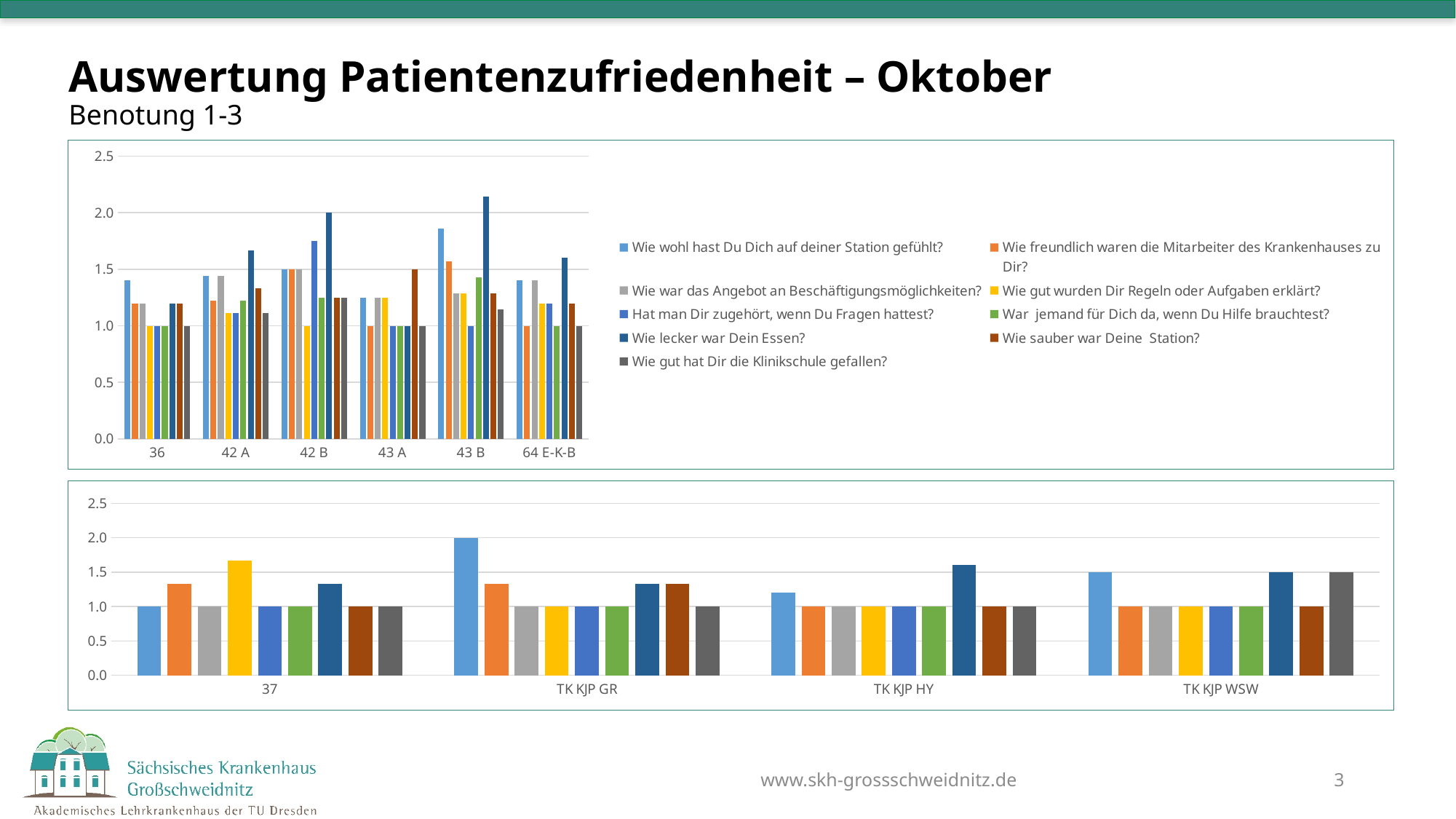
What is the title of the slide? Auswertung Patientenzufriedenheit – Oktober In the top chart, is the value for 'Wie wohl hast Du Dich auf deiner Station gefühlt?' for 43 B greater or less than 1.5? greater How many categories are shown on the x axis of the top chart? 6 In the bottom chart, what is the value for 'Wie gut hat Dir die Klinikschule gefallen?' for TK KJP WSW? 1.5 In the bottom chart, which category has the larger value for 'Wie gut wurden Dir Regeln oder Aufgaben erklärt?': 37 or TK KJP GR? 37 How many categories are shown on the x axis of the bottom chart? 4 In the bottom chart, what is the value for 'Wie wohl hast Du Dich auf deiner Station gefühlt?' for TK KJP GR? 2.0 In the top chart, what is the value for 'Wie lecker war Dein Essen?' for 42 B? 2.0 How many series does the legend list? 9 In the bottom chart, which category has the highest value for 'Wie wohl hast Du Dich auf deiner Station gefühlt?'? TK KJP GR What kind of chart is the top chart on the slide? bar chart In the bottom chart, what is the difference between 'Wie wohl hast Du Dich auf deiner Station gefühlt?' and 'Wie war das Angebot an Beschäftigungsmöglichkeiten?' for TK KJP GR? 1.0